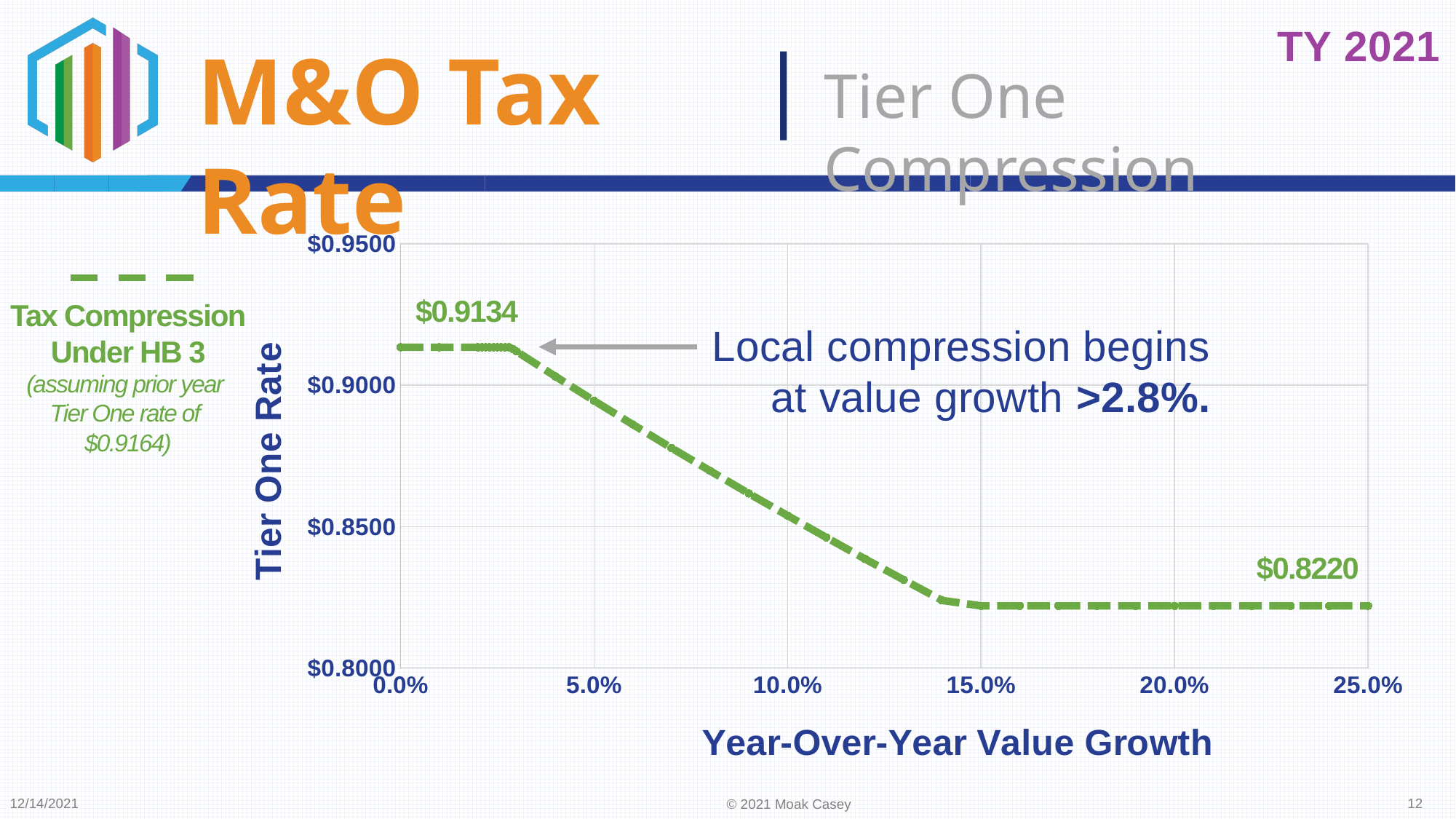
What is the title of the chart's x axis? Year-Over-Year Value Growth What is the Tier One Rate at 25.0% year-over-year value growth? $0.8220 Does the Tier One Rate rise or fall as year-over-year value growth increases along the x axis? fall How many series does the chart legend list? 1 Is the Tier One Rate at 20.0% value growth greater or less than $0.8500? less Which is larger, the Tier One Rate at 0.0% growth or at 25.0% growth? 0.0% growth What is the lowest Tier One Rate labeled on the chart? $0.8220 What is the Tier One Rate at 0.0% year-over-year value growth? $0.9134 What is the difference between the Tier One Rate at 0.0% growth and at 25.0% growth? $0.0914 What is the highest Tier One Rate labeled on the chart? $0.9134 Is the Tier One Rate at 10.0% value growth greater or less than $0.8500? greater What kind of chart is shown on the slide? line chart